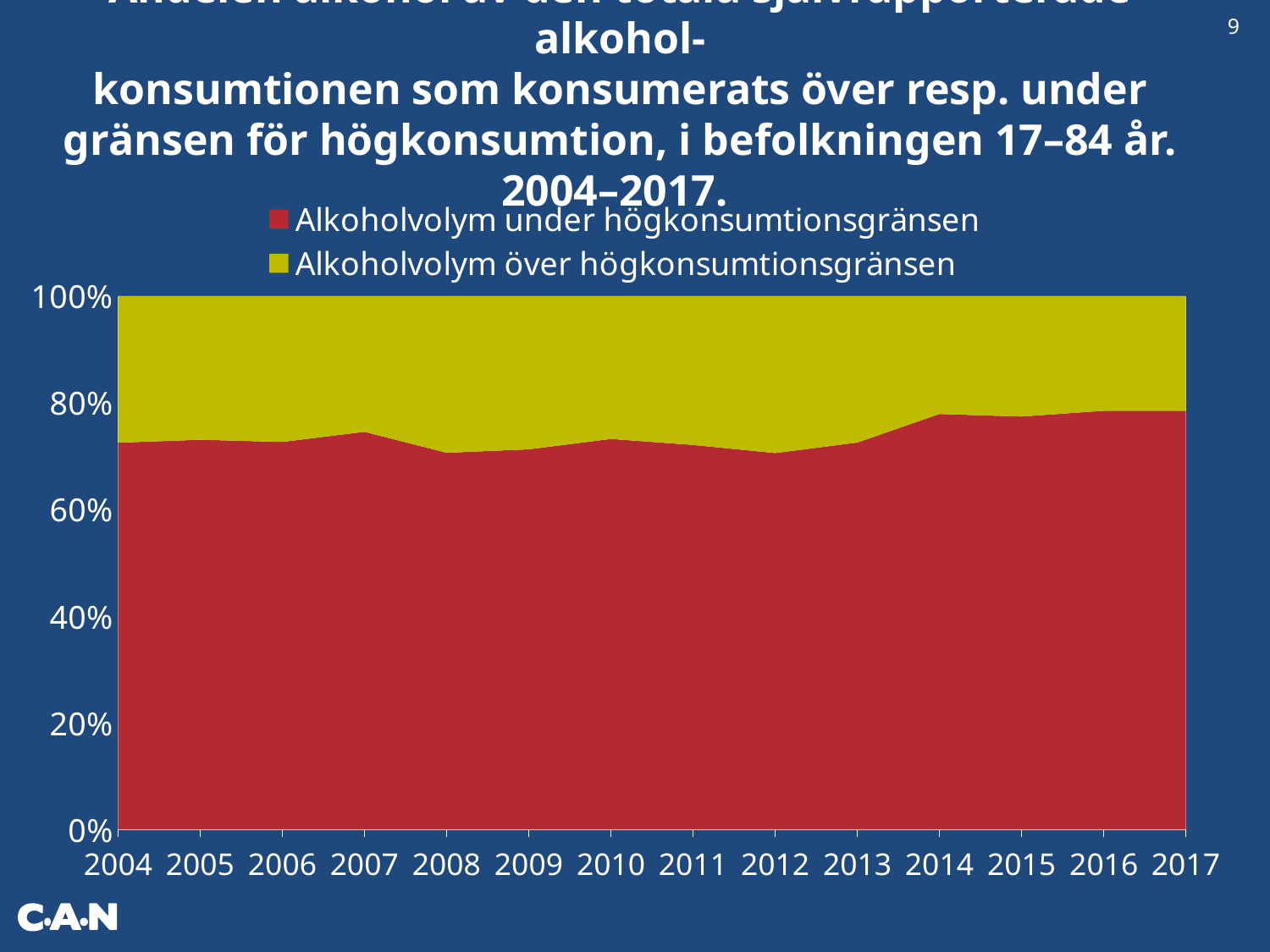
Is the value for Alkoholvolym under högkonsumtionsgränsen in 2008 greater or less than 60%? greater Does the share for Alkoholvolym under högkonsumtionsgränsen rise or fall between 2013 and 2014? rise Which is larger for Alkoholvolym över högkonsumtionsgränsen: the share in 2008 or the share in 2017? 2008 What kind of chart is shown on the slide? Area chart How many years are shown along the x axis? 14 Is the share for Alkoholvolym över högkonsumtionsgränsen in 2010 greater or less than 40%? less Is the value for Alkoholvolym under högkonsumtionsgränsen in 2012 greater or less than 80%? less Which series is shown in red? Alkoholvolym under högkonsumtionsgränsen Which series is shown in yellow? Alkoholvolym över högkonsumtionsgränsen Which is larger for Alkoholvolym under högkonsumtionsgränsen: the value in 2008 or the value in 2017? 2017 How many series does the legend list? 2